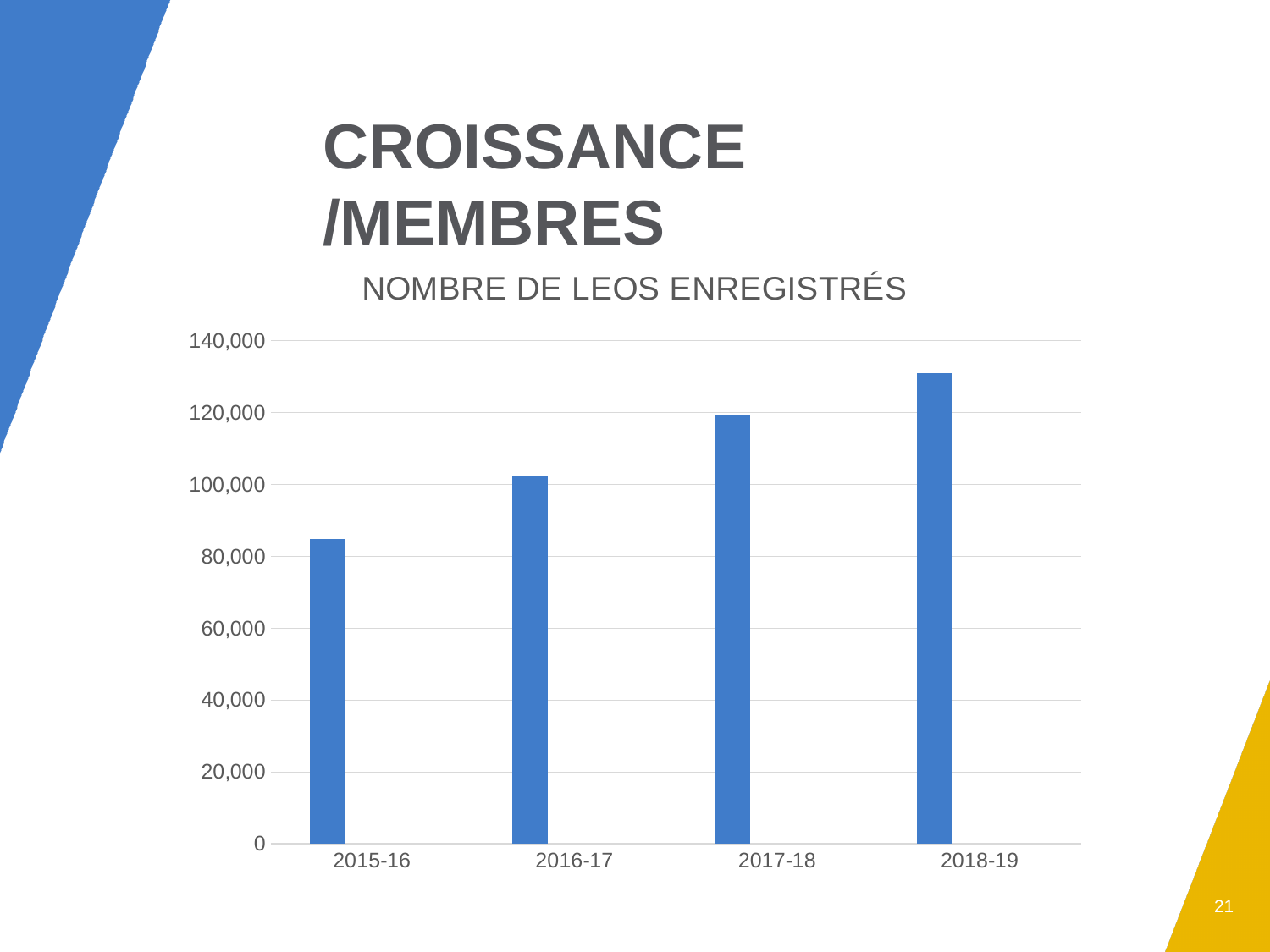
Is the value for 2018-19 greater or less than 120,000? greater Which year has the highest number of registered Leos? 2018-19 Do the values rise or fall from 2015-16 to 2018-19? rise How many categories are shown on the x axis of the chart? 4 What is the title of the chart? NOMBRE DE LEOS ENREGISTRÉS What kind of chart is shown on the slide? bar chart Is the value for 2015-16 greater or less than 100,000? less Is the value for 2016-17 greater or less than 100,000? greater Which is larger, the value for 2016-17 or the value for 2017-18? 2017-18 What is the highest value shown on the vertical axis of the chart? 140,000 Which year has the lowest number of registered Leos? 2015-16